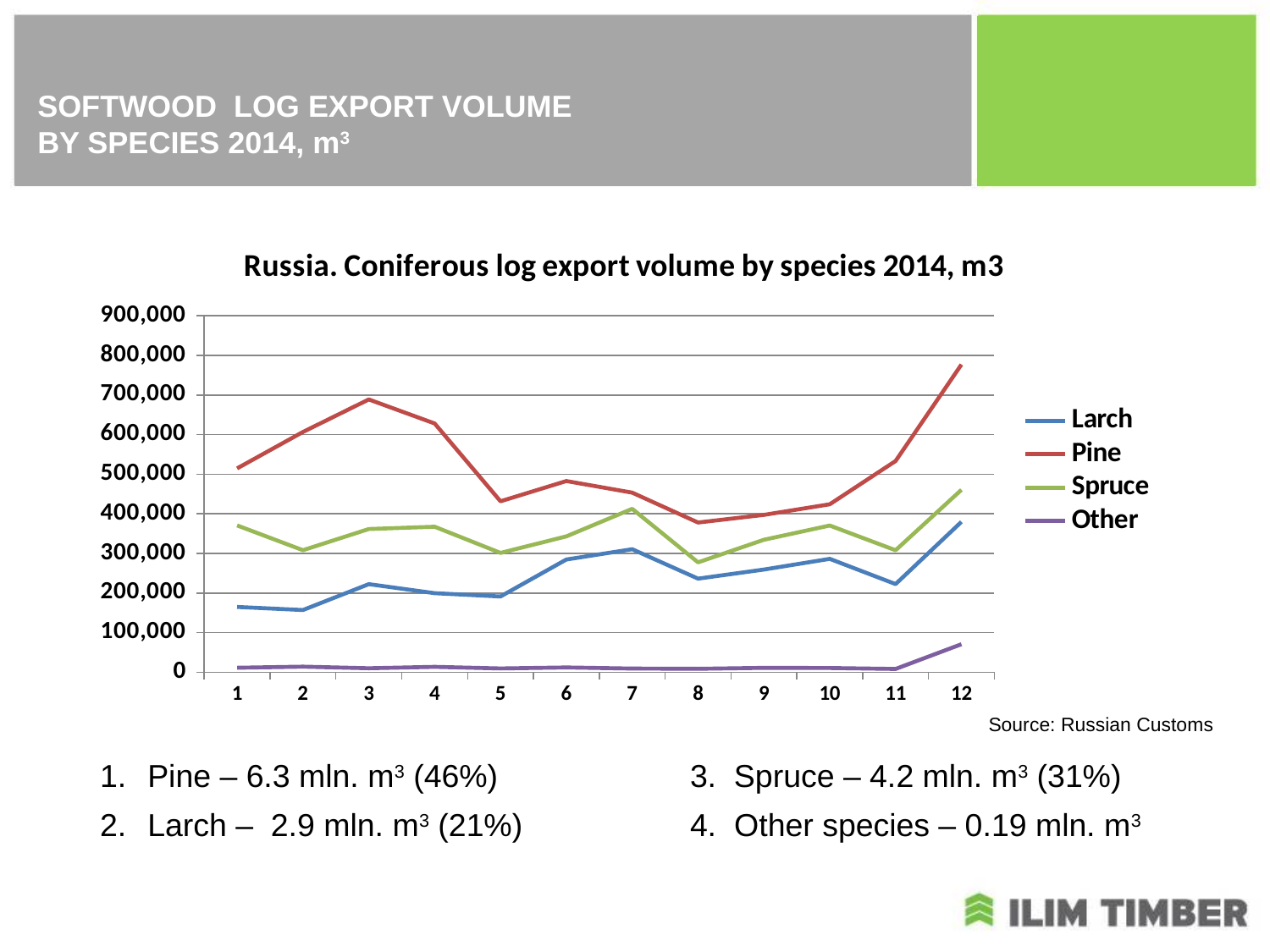
At which x-axis point does the Pine series reach its highest value? 12 Is the value for Pine at point 12 greater or less than 700,000? greater What is the title of the chart? Russia. Coniferous log export volume by species 2014, m3 How many points are plotted along the x axis for each series? 12 Does the Pine series rise or fall from point 8 to point 12? rise Which series has the lowest values across the whole chart? Other Is the value for Other at point 12 greater or less than 100,000? less What kind of chart is shown on the slide? line chart At point 7, which is larger: Larch or Spruce? Spruce How many series does the chart legend list? 4 Which series has the highest value at point 12? Pine Is the value for Larch at point 1 greater or less than 200,000? less